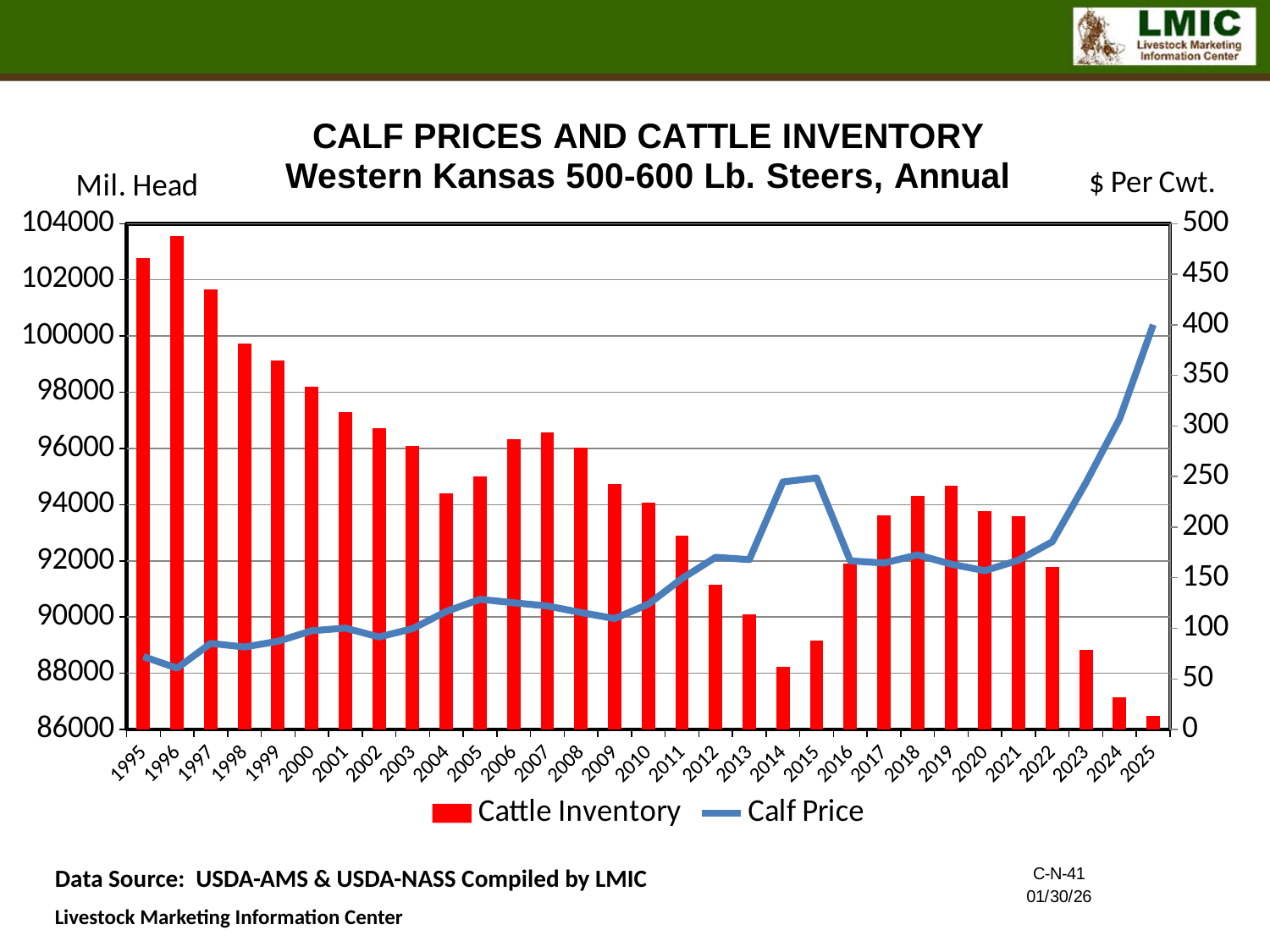
Which year has the larger Cattle Inventory, 2016 or 2017? 2017 How many years are shown along the x axis? 31 Is the Cattle Inventory value for 1995 greater or less than 100000? greater In which year is the Cattle Inventory bar the highest? 1996 In which year is the Cattle Inventory bar the lowest? 2025 In which year does the Calf Price line reach its highest point? 2025 How many series does the legend list? 2 Is the Cattle Inventory value for 2025 greater or less than 88000? less Does the Calf Price line rise or fall from 2022 to 2025? rise What is the label on the right-hand vertical axis? $ Per Cwt. Is the Calf Price value for 2014 greater or less than 200? greater What kind of chart is shown on the slide? A combination bar and line chart